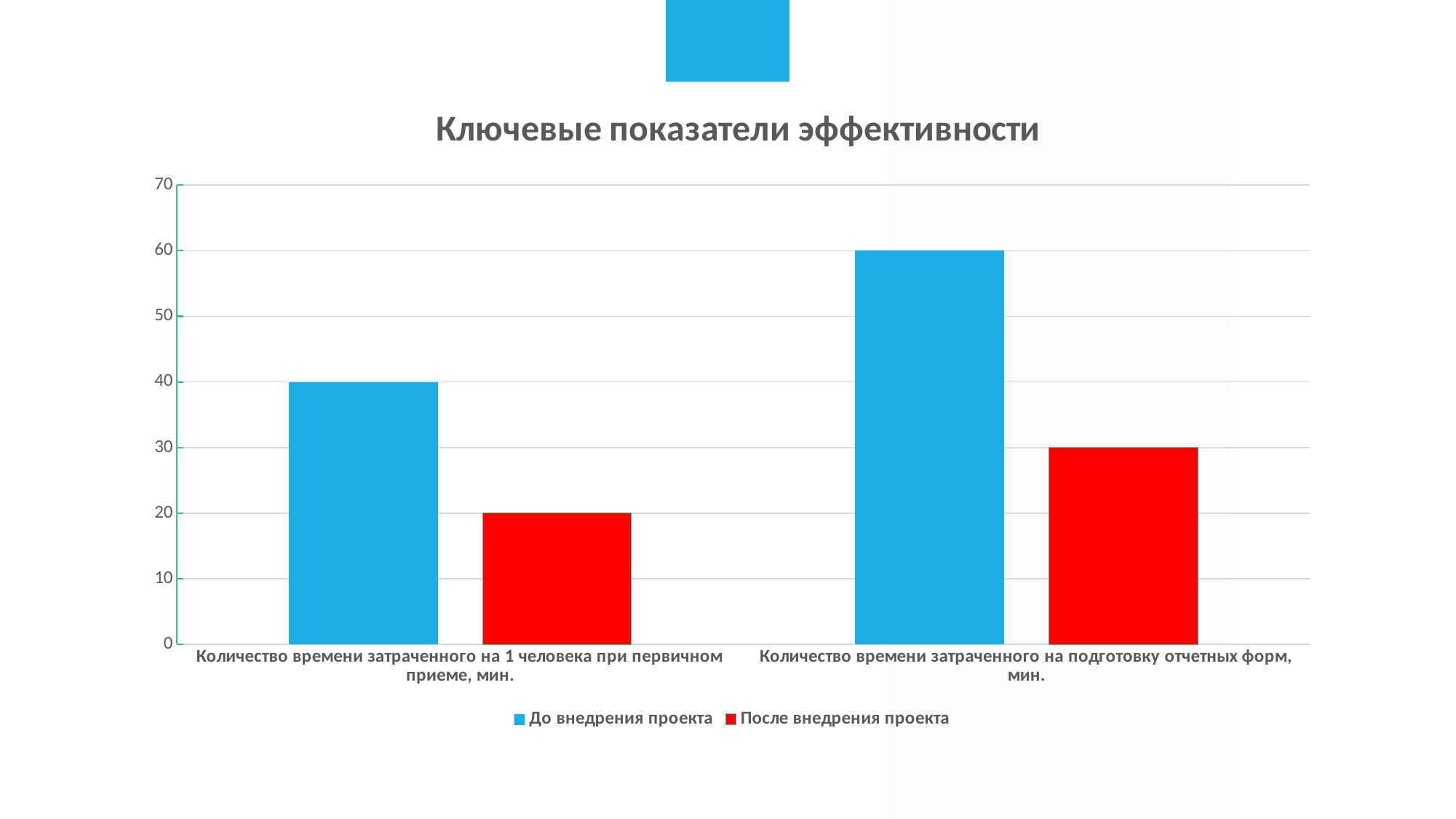
How many series does the legend list? 2 Which bar is the highest on the chart? До внедрения проекта, Количество времени затраченного на подготовку отчетных форм, мин. What is the value for 'До внедрения проекта' in the category 'Количество времени затраченного на 1 человека при первичном приеме, мин.'? 40 What colour represents the series 'После внедрения проекта'? Red What is the value for 'После внедрения проекта' in the category 'Количество времени затраченного на 1 человека при первичном приеме, мин.'? 20 Which is larger for 'Количество времени затраченного на 1 человека при первичном приеме, мин.': 'До внедрения проекта' or 'После внедрения проекта'? До внедрения проекта What is the title of the chart? Ключевые показатели эффективности How many categories are shown on the x axis? 2 What kind of chart is shown on the slide? Bar chart What is the value for 'До внедрения проекта' in the category 'Количество времени затраченного на подготовку отчетных форм, мин.'? 60 What is the value for 'После внедрения проекта' in the category 'Количество времени затраченного на подготовку отчетных форм, мин.'? 30 What is the difference between 'До внедрения проекта' and 'После внедрения проекта' for 'Количество времени затраченного на подготовку отчетных форм, мин.'? 30